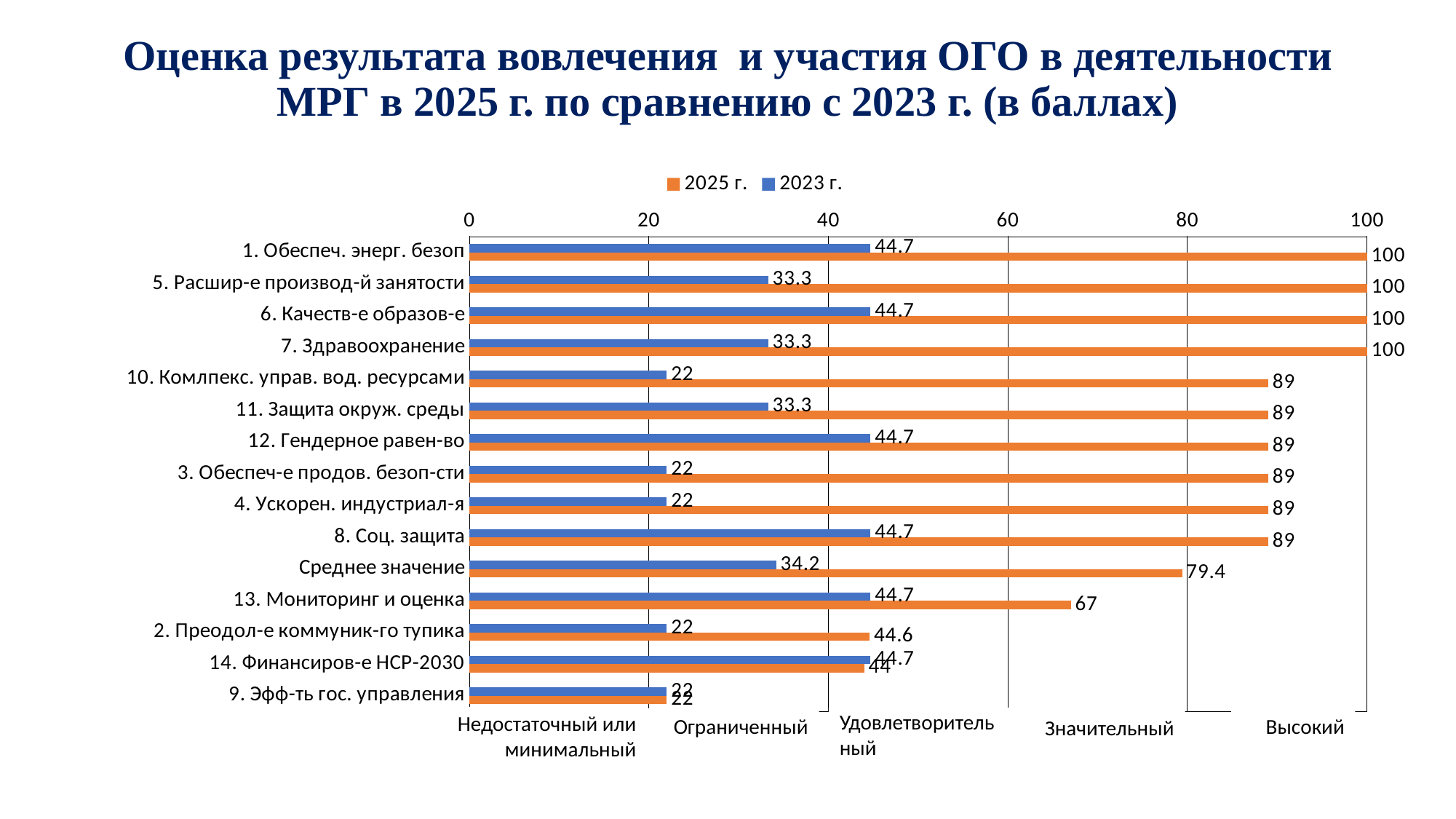
Which category has the lowest value for 2025 г.? 9. Эфф-ть гос. управления What type of chart is shown on the slide? bar chart How many series does the legend list? 2 What is the difference between the 2025 г. and 2023 г. values for "10. Комлпекс. управ. вод. ресурсами"? 67 How many categories are plotted on the chart? 15 What is the value for 2025 г. for "13. Мониторинг и оценка"? 67 What is the value for 2025 г. for "Среднее значение"? 79.4 Which is larger for "2. Преодол-е коммуник-го тупика": the 2025 г. value or the 2023 г. value? 2025 г. What is the difference between the 2025 г. and 2023 г. values for "Среднее значение"? 45.2 Which colour represents the 2023 г. series in the legend? blue What is the value for 2025 г. for "7. Здравоохранение"? 100 What is the value for 2023 г. for "5. Расшир-е производ-й занятости"? 33.3